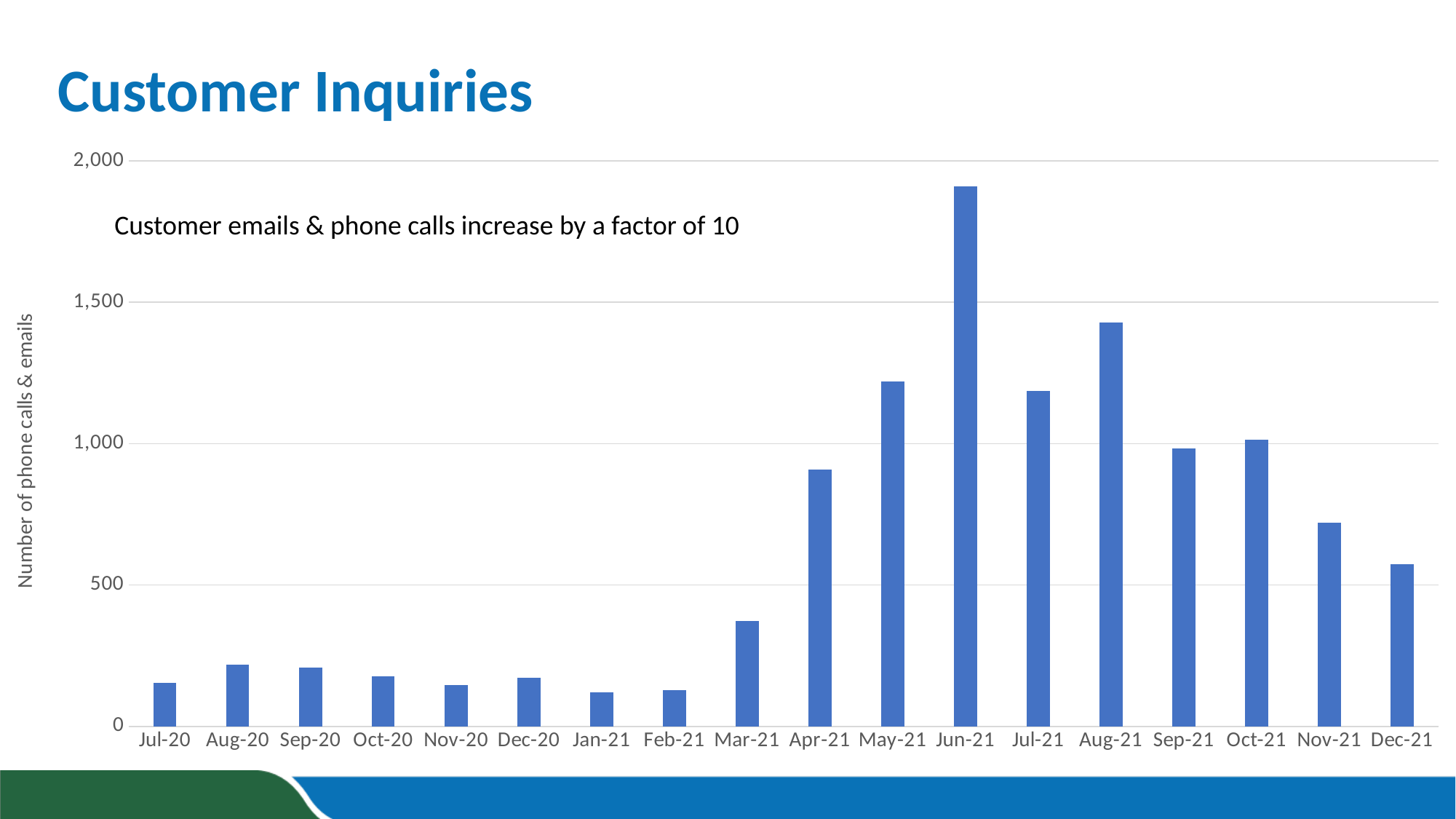
Which is larger, the value for Jun-21 or the value for Aug-21? Jun-21 Is the value for Nov-21 greater or less than 500? greater What is the label on the vertical axis? Number of phone calls & emails Is the value for Jun-21 greater or less than 1,500? greater How many months are plotted on the x axis? 18 Do the values rise or fall from Jun-21 to Dec-21? Fall Which is larger, the value for Nov-21 or the value for Dec-21? Nov-21 Which month has the highest number of phone calls and emails? Jun-21 Is the value for Mar-21 greater or less than 500? less What kind of chart is shown on the slide? Bar chart